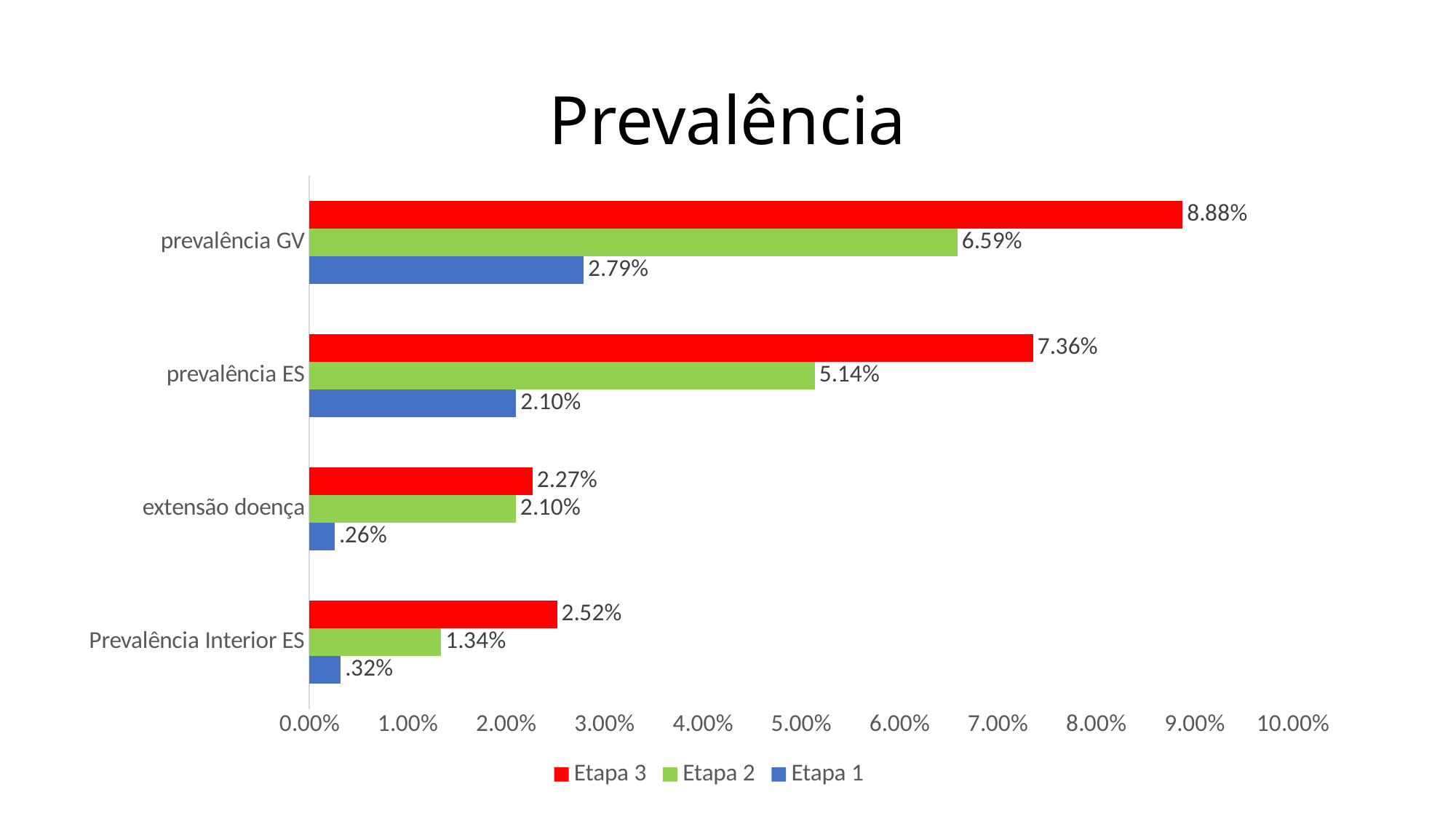
How many categories are shown on the chart? 4 Which is larger: the Etapa 3 value for extensão doença or the Etapa 3 value for Prevalência Interior ES? Prevalência Interior ES What is the Etapa 1 value for extensão doença? .26% What is the Etapa 3 value for prevalência GV? 8.88% Which category has the lowest Etapa 1 value? extensão doença What is the title of the chart? Prevalência What is the Etapa 2 value for Prevalência Interior ES? 1.34% What is the difference between the Etapa 3 and Etapa 1 values for prevalência ES? 5.26% Which category has the highest Etapa 2 value? prevalência GV What kind of chart is shown on the slide? bar chart Which colour represents Etapa 2 in the legend? green How many series does the legend list? 3